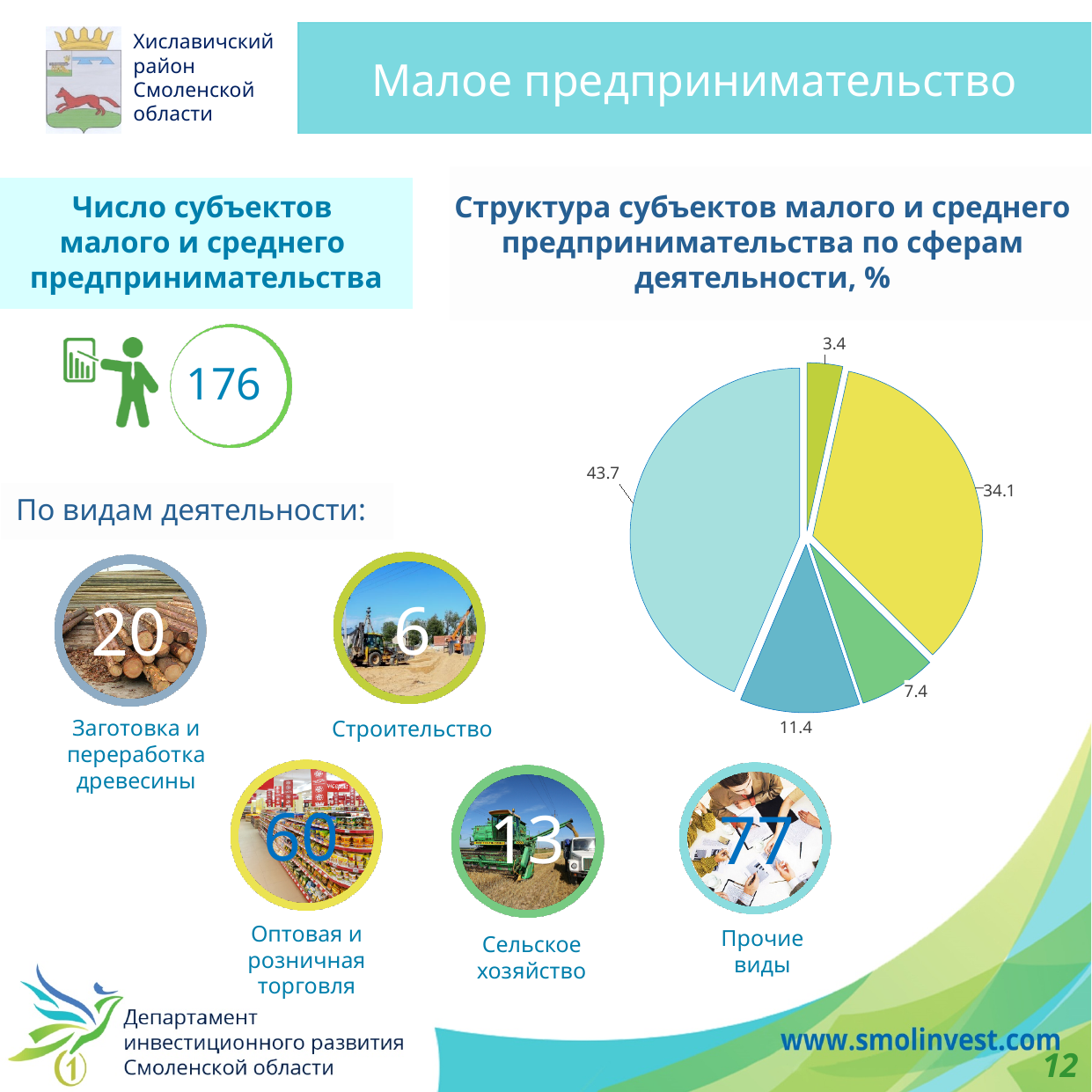
In the pie chart, which is larger: the slice labelled 34.1 or the slice labelled 11.4? 34.1 What is the value of the smallest slice in the pie chart? 3.4 What is the sum of all the slice values shown in the pie chart? 100 What is the title of the pie chart on the slide? Структура субъектов малого и среднего предпринимательства по сферам деятельности, % What is the value of the largest slice in the pie chart? 43.7 How many slices does the pie chart have? 5 What value is labelled on the yellow slice of the pie chart? 34.1 What kind of chart is shown under the title 'Структура субъектов малого и среднего предпринимательства по сферам деятельности, %'? pie chart Is the largest slice of the pie chart greater or less than 40? greater What is the difference between the slices labelled 11.4 and 7.4 in the pie chart? 4.0 What share of the pie does the second-largest slice represent? 34.1 What is the difference between the two largest slices of the pie chart (43.7 and 34.1)? 9.6